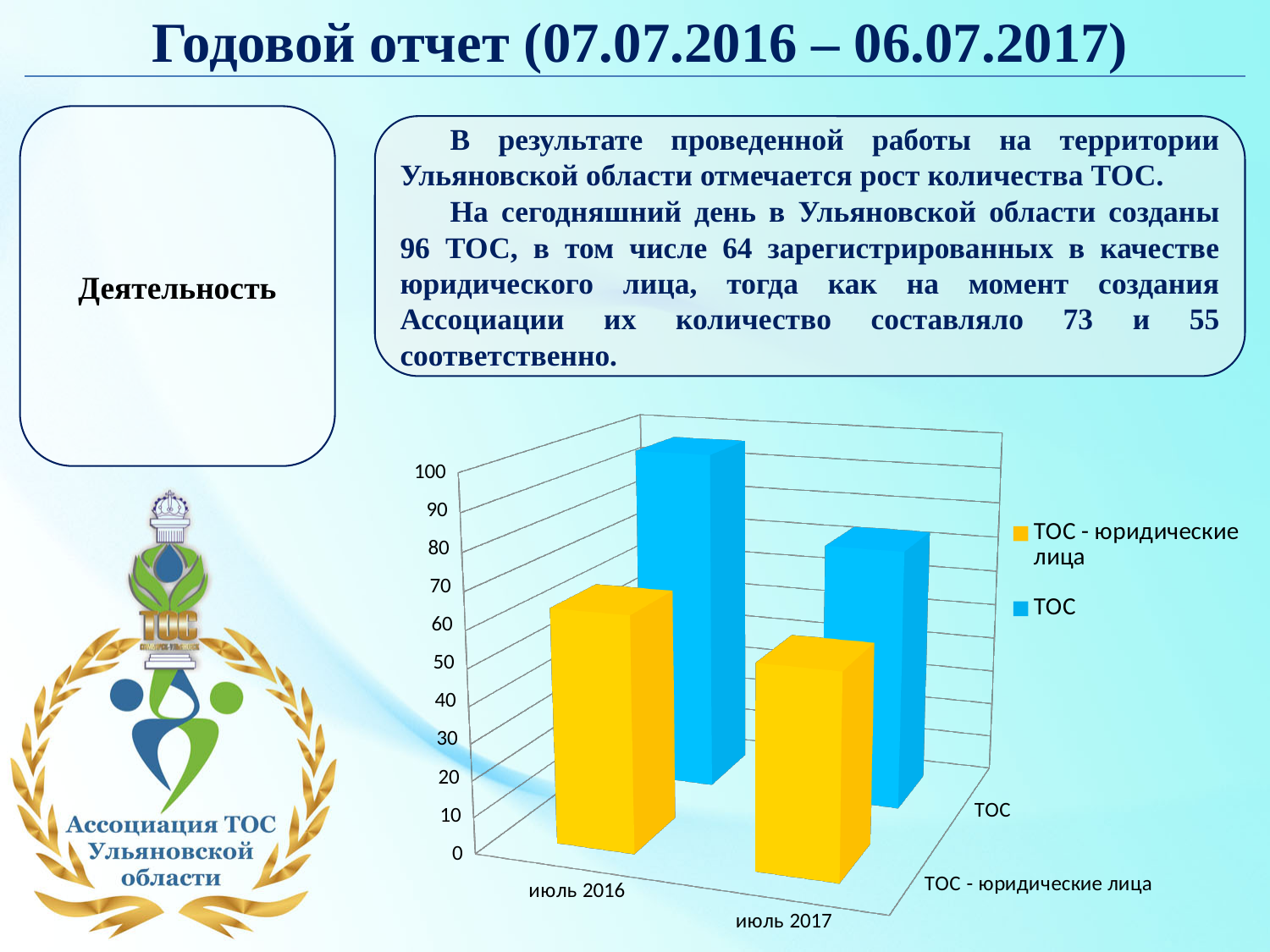
How many series does the chart legend list? 2 How many categories are shown along the x axis of the chart? 2 Is the value for ТОС in июль 2016 greater or less than 70? greater For июль 2016, which series has the taller bar: ТОС or ТОС - юридические лица? ТОС Which series is shown in blue in the chart? ТОС Is the value for ТОС - юридические лица in июль 2017 greater or less than 20? greater For июль 2017, which series has the taller bar: ТОС or ТОС - юридические лица? ТОС What kind of chart is shown on the slide? bar chart What is the highest tick value shown on the vertical axis of the chart? 100 Which series is shown in yellow in the chart? ТОС - юридические лица Is the value for ТОС - юридические лица in июль 2016 greater or less than 40? greater